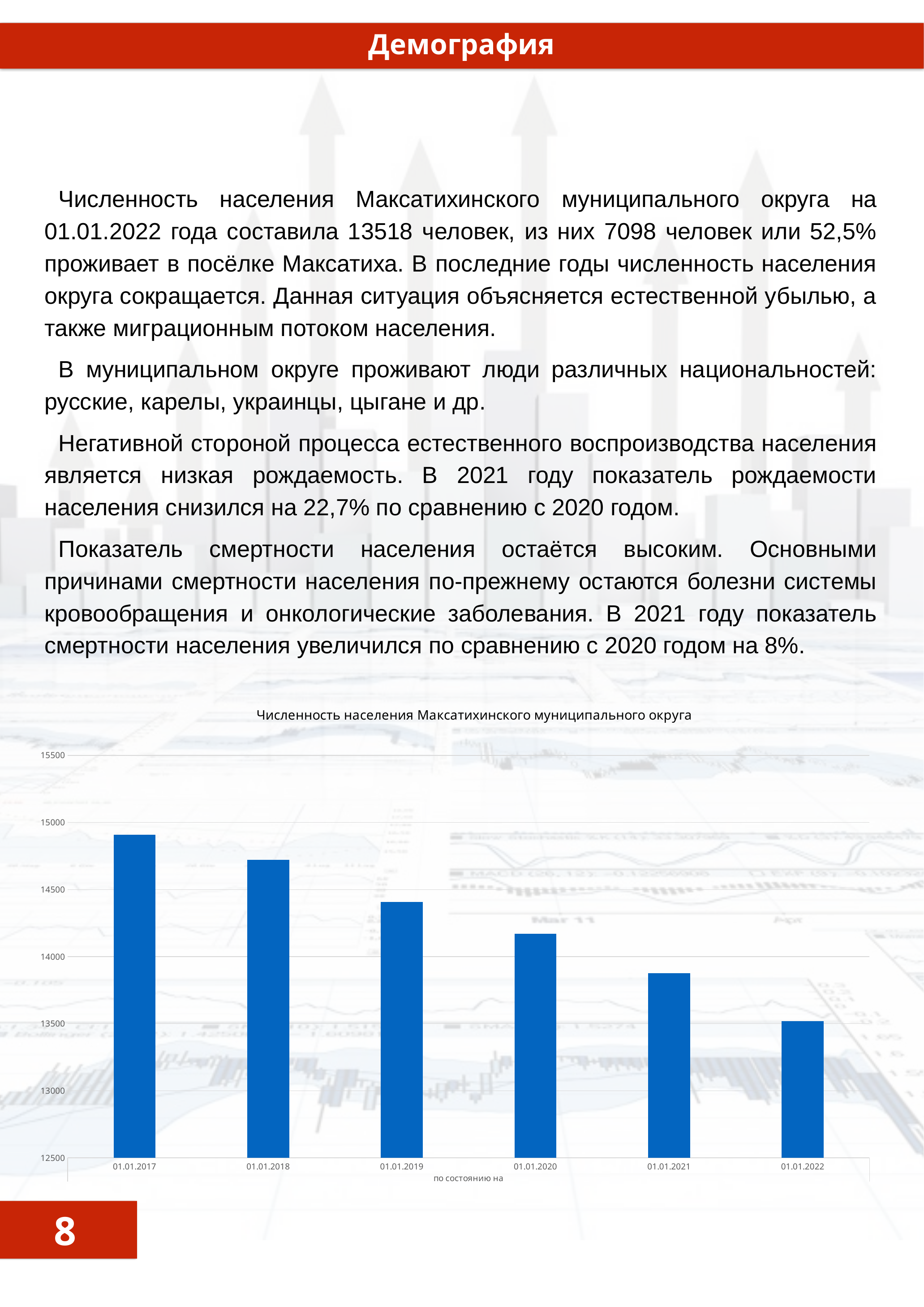
Which date has the highest population value in the chart? 01.01.2017 Which is larger, the value for 01.01.2018 or the value for 01.01.2021? 01.01.2018 Is the value for 01.01.2019 greater or less than 14500? less What is the label of the x axis of the chart? по состоянию на Is the value for 01.01.2017 greater or less than 14500? greater Which date has the lowest population value in the chart? 01.01.2022 What is the title of the chart? Численность населения Максатихинского муниципального округа Is the value for 01.01.2021 greater or less than 14000? less What kind of chart is shown on the slide? Bar chart How many dates (bars) are shown on the x axis of the chart? 6 Do the population values rise or fall from 01.01.2017 to 01.01.2022? Fall